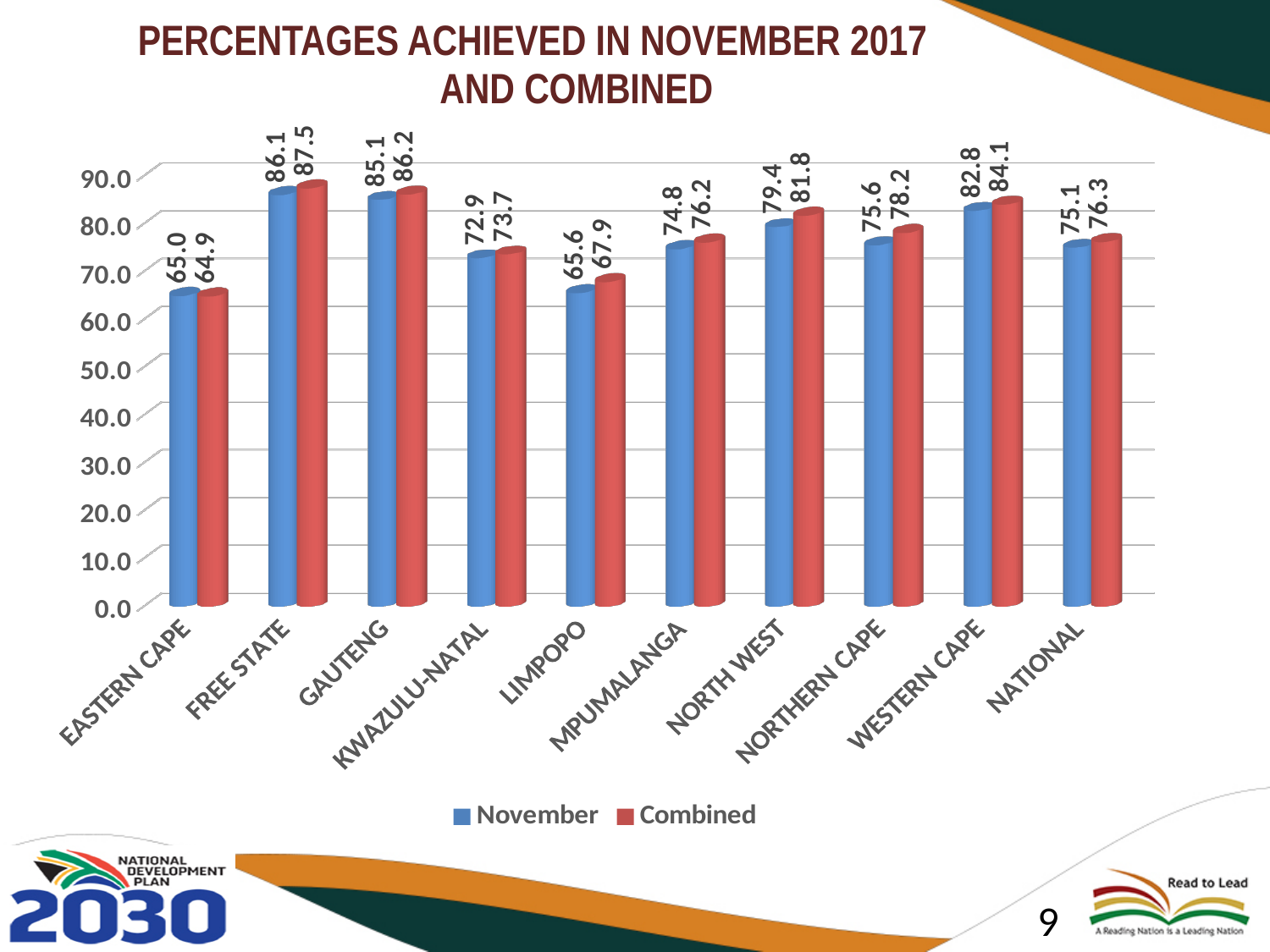
How many categories are shown on the x axis? 10 What is the November value for National? 75.1 What is the November value for Gauteng? 85.1 Which is larger for Western Cape, the November value or the Combined value? Combined Which category has the lowest November value? Eastern Cape What kind of chart is shown on the slide? Bar chart What colour are the Combined bars? Red Which category has the highest Combined value? Free State How many series does the legend list? 2 What is the difference between the Combined and November values for North West? 2.4 Is the Combined value for Limpopo greater or less than 70.0? less What is the Combined value for Northern Cape? 78.2